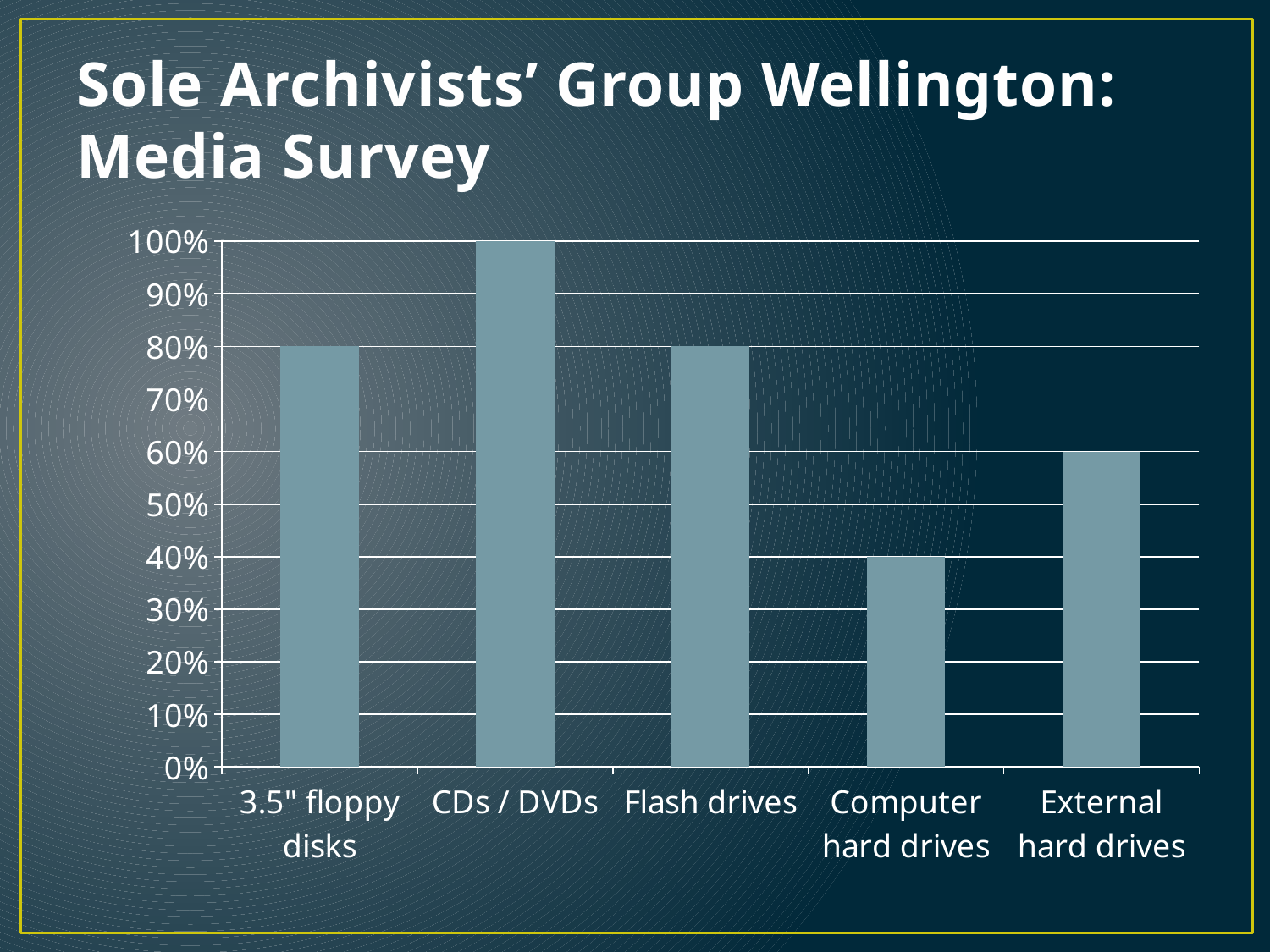
How many categories are shown on the x axis? 5 What is the value for External hard drives? 60% What is the value for 3.5" floppy disks? 80% What kind of chart is shown on the slide? bar chart Is the value for External hard drives greater or less than 50%? greater Which is larger, the value for Flash drives or the value for External hard drives? Flash drives Which category has the lowest value? Computer hard drives Which category has the highest value? CDs / DVDs What is the value for CDs / DVDs? 100% What is the title of the slide containing the chart? Sole Archivists' Group Wellington: Media Survey What is the value for Computer hard drives? 40% What is the difference between the values for CDs / DVDs and Computer hard drives? 60%